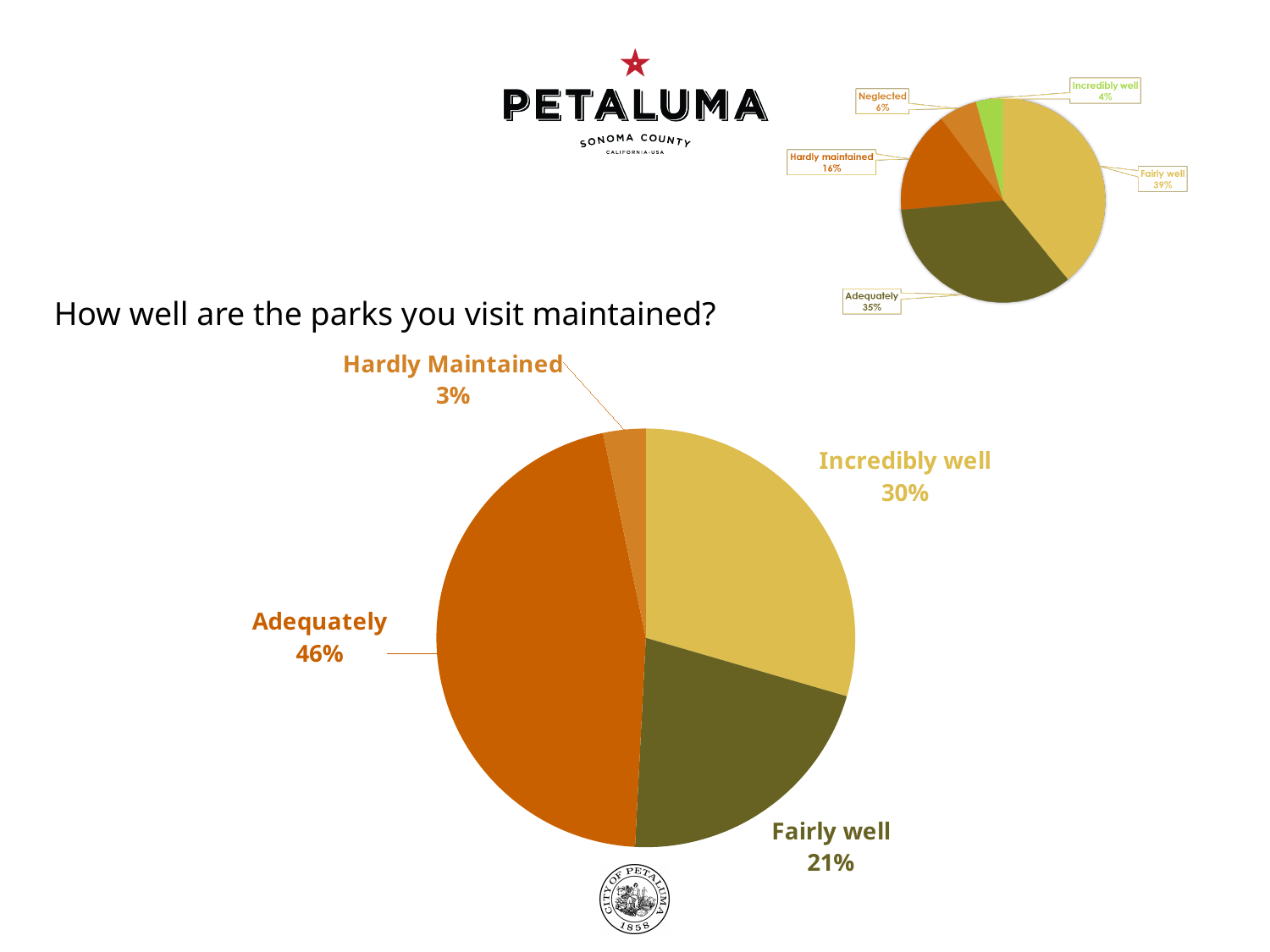
In the large pie chart at the bottom of the slide, which is larger: Incredibly well or Fairly well? Incredibly well In the small pie chart in the top right of the slide, what share is labelled Fairly well? 39% In the large pie chart at the bottom of the slide, which category has the largest share? Adequately In the large pie chart at the bottom of the slide, what share is labelled Adequately? 46% In the large pie chart at the bottom of the slide, what share is labelled Incredibly well? 30% In the small pie chart in the top right of the slide, how many categories are shown? 5 What kind of chart is the large chart at the bottom of the slide? Pie chart In the small pie chart in the top right of the slide, what share is labelled Neglected? 6% In the large pie chart at the bottom of the slide, which category has the smallest share? Hardly Maintained In the large pie chart at the bottom of the slide, what is the difference between the Adequately share and the Fairly well share? 25% In the small pie chart in the top right of the slide, which category has the smallest share? Incredibly well In the large pie chart at the bottom of the slide, how many categories are shown? 4